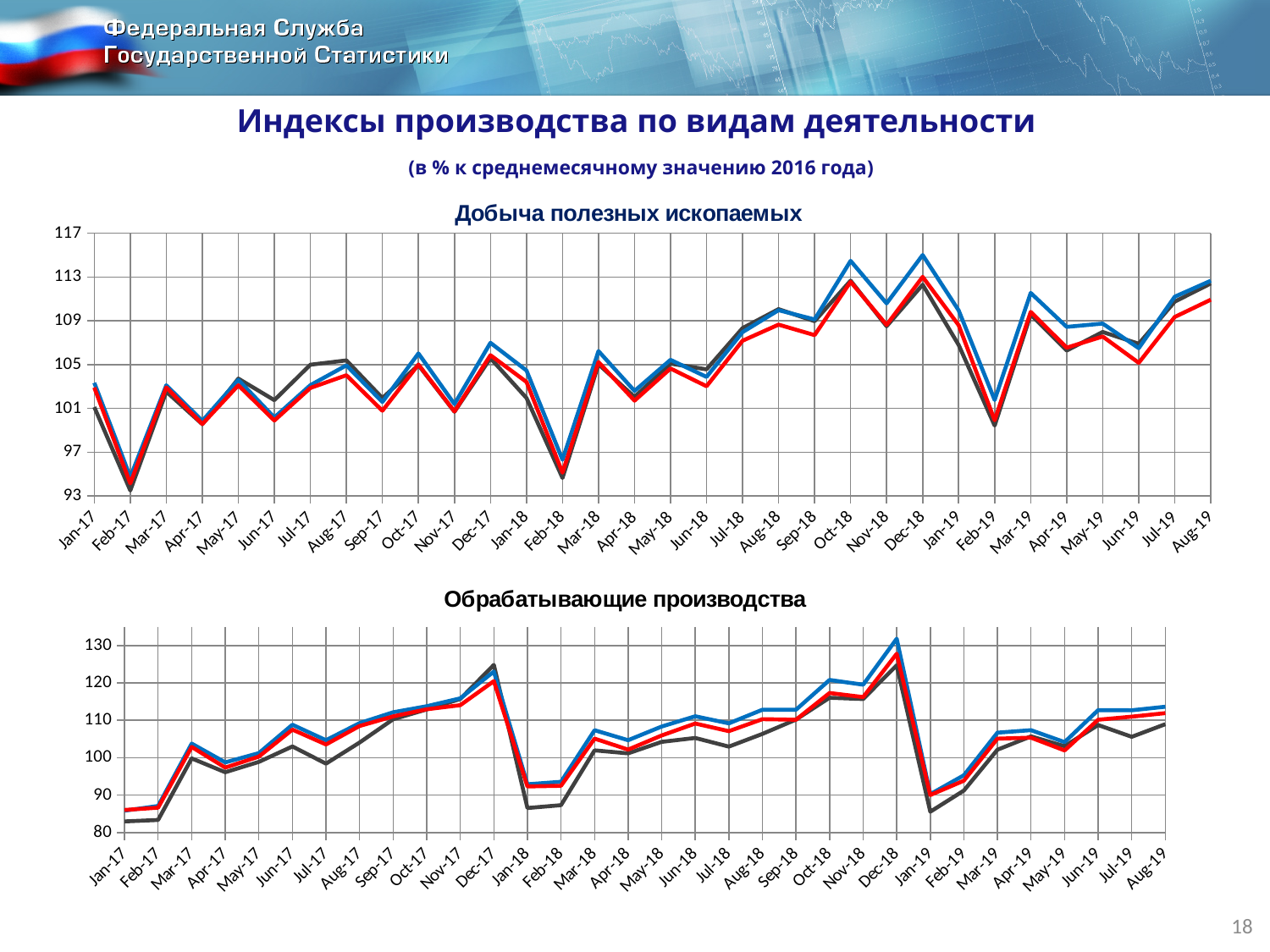
What kind of chart is the bottom chart titled "Обрабатывающие производства"? line chart What kind of chart is the top chart titled "Добыча полезных ископаемых"? line chart In the top chart "Добыча полезных ископаемых", is the blue line's value for Dec-18 greater or less than 113? greater How many months are plotted along the x axis of the top chart "Добыча полезных ископаемых"? 32 In the top chart "Добыча полезных ископаемых", which month has the lowest value for all lines? Feb-17 In the top chart "Добыча полезных ископаемых", do the lines rise or fall from Jan-19 to Feb-19? fall In the bottom chart "Обрабатывающие производства", which month has the highest value? Dec-18 In the bottom chart "Обрабатывающие производства", do the lines rise or fall from Dec-18 to Jan-19? fall In the top chart "Добыча полезных ископаемых", is the value for Feb-17 greater or less than 97? less In the top chart "Добыча полезных ископаемых", which is larger for the blue line: Oct-18 or Nov-18? Oct-18 In the bottom chart "Обрабатывающие производства", is the value for Jan-18 greater or less than 100? less How many lines are plotted in the bottom chart "Обрабатывающие производства"? 3